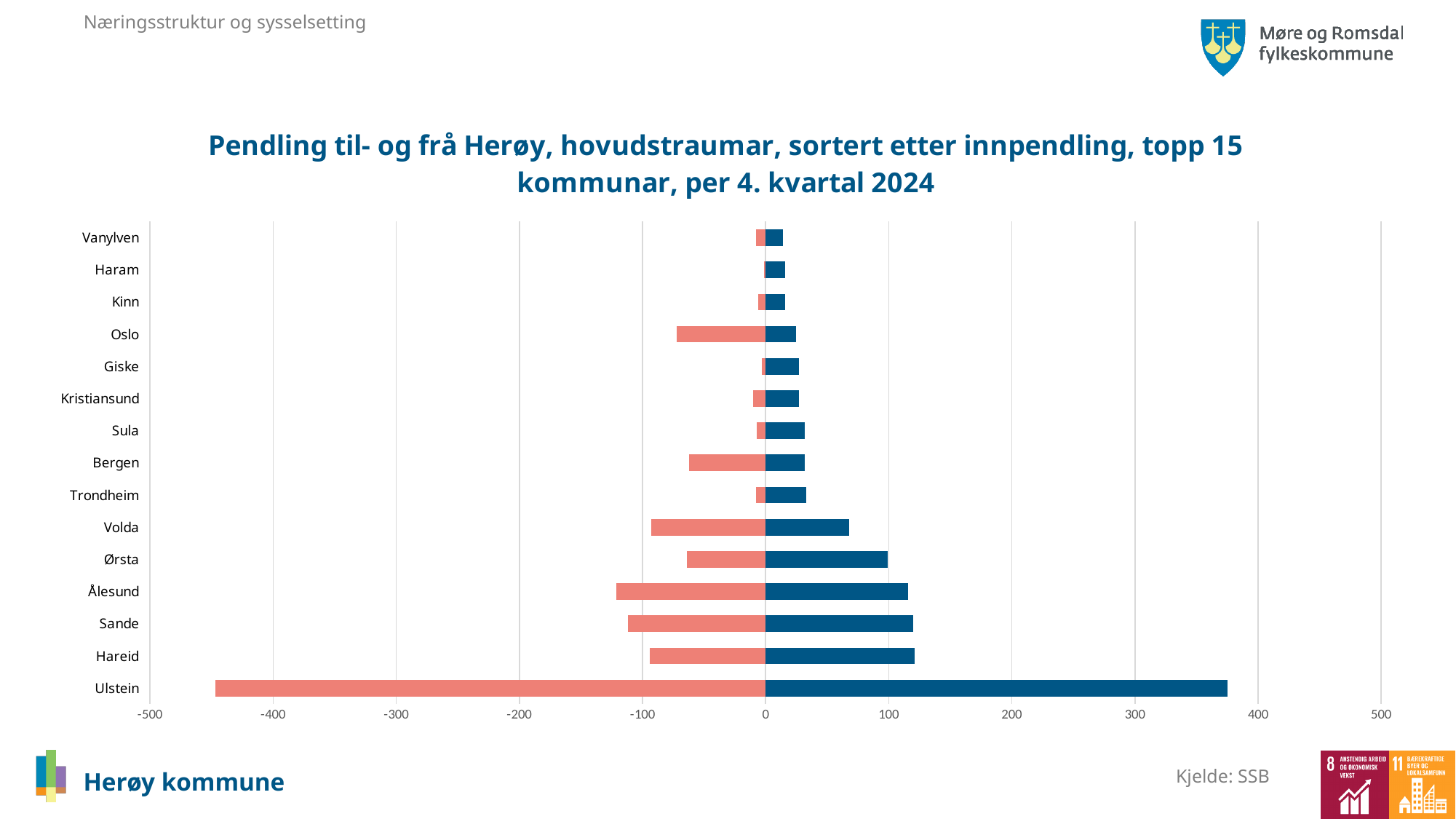
Which municipality has the longest red (negative) bar? Ulstein Is the blue bar value for Oslo greater or less than 100? less Is the blue bar value for Ulstein greater or less than 300? greater Is the blue bar value for Volda greater or less than 100? less Which has the longer red bar, Ålesund or Oslo? Ålesund What kind of chart is shown on the slide? bar chart Which municipality has the longest blue (positive) bar? Ulstein What is the title of the chart? Pendling til- og frå Herøy, hovudstraumar, sortert etter innpendling, topp 15 kommunar, per 4. kvartal 2024 Which has the larger blue bar, Ørsta or Volda? Ørsta How many municipalities (categories) are listed on the chart? 15 What is the source cited for the chart data? SSB